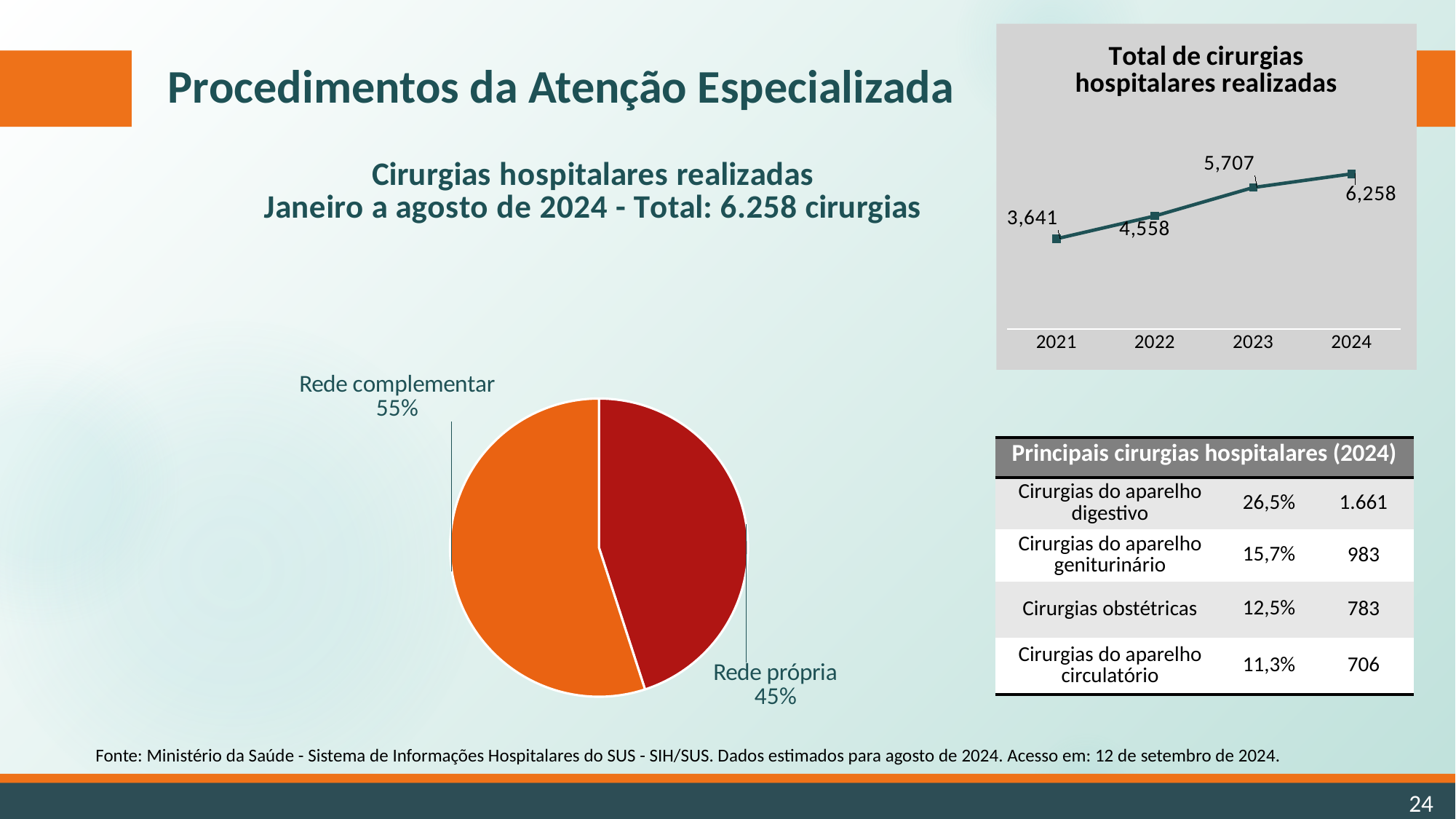
In the pie chart 'Cirurgias hospitalares realizadas', what colour is the 'Rede própria' slice? red In the line chart 'Total de cirurgias hospitalares realizadas', do the values rise or fall from 2021 to 2024? rise In the line chart 'Total de cirurgias hospitalares realizadas', which year has the lowest value? 2021 In the pie chart 'Cirurgias hospitalares realizadas', what share does 'Rede complementar' have? 55% In the pie chart 'Cirurgias hospitalares realizadas', which slice is larger, 'Rede própria' or 'Rede complementar'? Rede complementar In the line chart 'Total de cirurgias hospitalares realizadas', what is the value for 2021? 3,641 In the line chart 'Total de cirurgias hospitalares realizadas', what is the difference between the 2023 and 2022 values? 1,149 What kind of chart is 'Total de cirurgias hospitalares realizadas'? line chart In the line chart 'Total de cirurgias hospitalares realizadas', what is the value for 2023? 5,707 In the line chart 'Total de cirurgias hospitalares realizadas', which year has the highest value? 2024 In the line chart 'Total de cirurgias hospitalares realizadas', what is the difference between the 2024 and 2021 values? 2,617 How many years are plotted in the line chart 'Total de cirurgias hospitalares realizadas'? 4